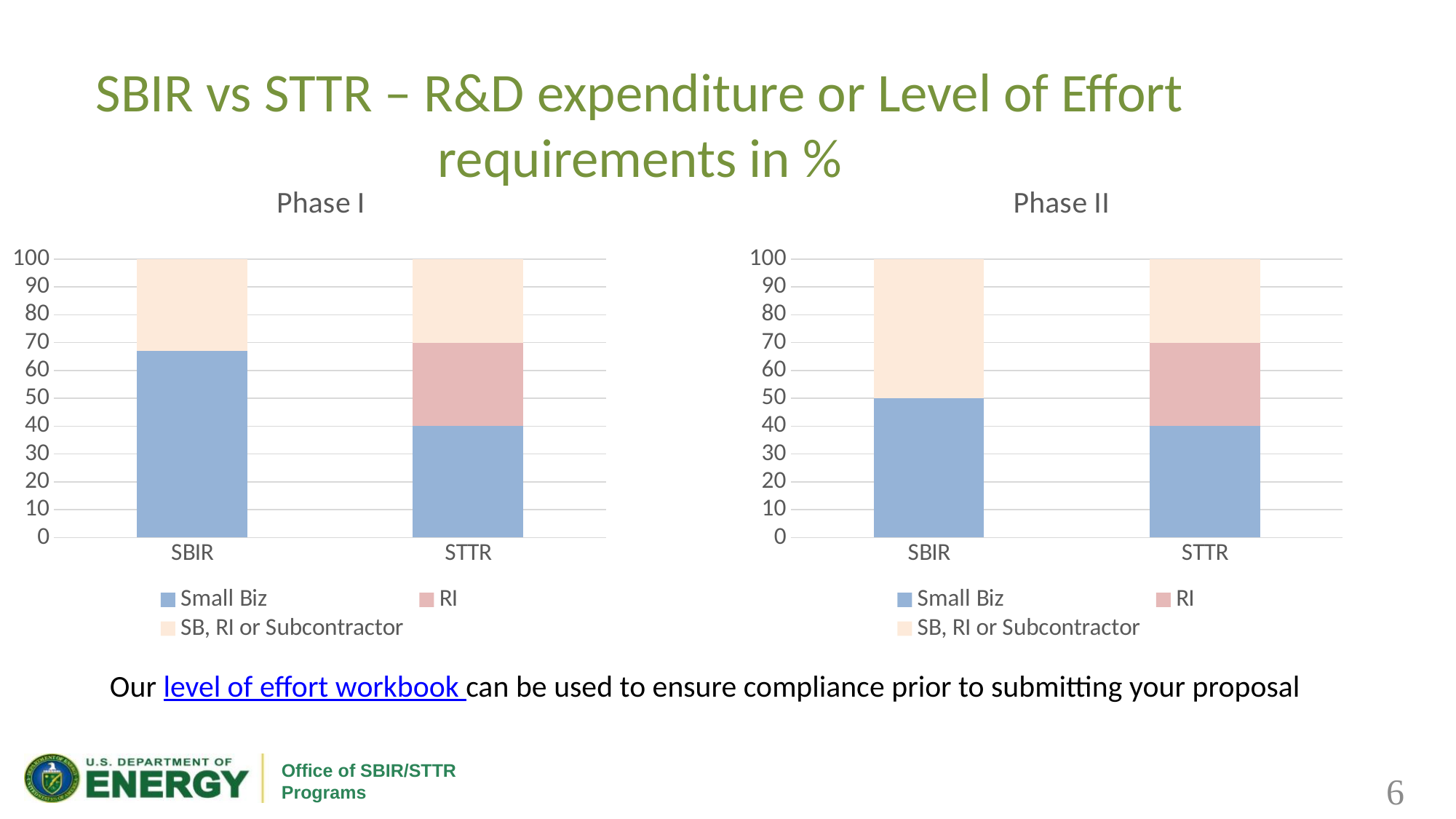
In the Phase II chart, what is the Small Biz value for SBIR? 50 In the Phase I chart, is the Small Biz value for SBIR greater or less than 60? greater In the Phase I chart, is the Small Biz value for SBIR greater or less than 70? less In the Phase II chart, what is the total of the stacked bar for STTR? 100 In the Phase II chart, which category has the higher Small Biz value? SBIR What kind of chart is the Phase I chart? stacked bar chart In the Phase II chart, what is the Small Biz value for STTR? 40 How many categories are shown on the x axis of the Phase I chart? 2 In the Phase I chart, what is the Small Biz value for STTR? 40 How many series does the legend of the Phase II chart list? 3 In the Phase I chart, which category has the larger Small Biz value, SBIR or STTR? SBIR Which legend entry is shown in the lightest (peach) colour in the Phase I chart? SB, RI or Subcontractor